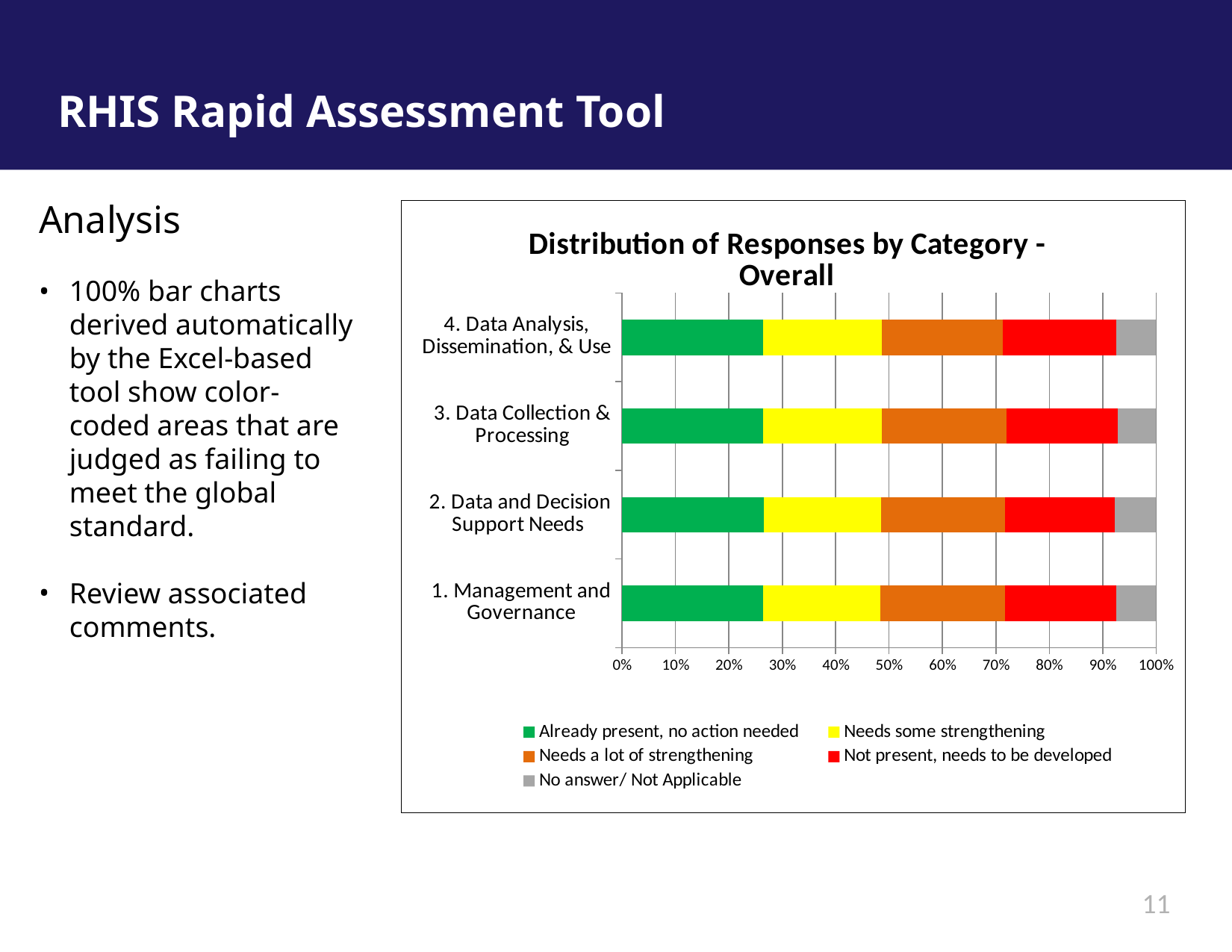
What is the title of the chart? Distribution of Responses by Category - Overall Is the "Already present, no action needed" share for "4. Data Analysis, Dissemination, & Use" greater or less than 30%? less How many categories are plotted on the chart? 4 Is the "Not present, needs to be developed" share for "4. Data Analysis, Dissemination, & Use" greater or less than 30%? less Is the "Already present, no action needed" share for "1. Management and Governance" greater or less than 20%? greater How many series does the chart's legend list? 5 What kind of chart is shown on the slide? Stacked bar chart Which colour represents "Needs some strengthening" in the chart? Yellow What is the maximum value shown on the horizontal axis of the chart? 100%